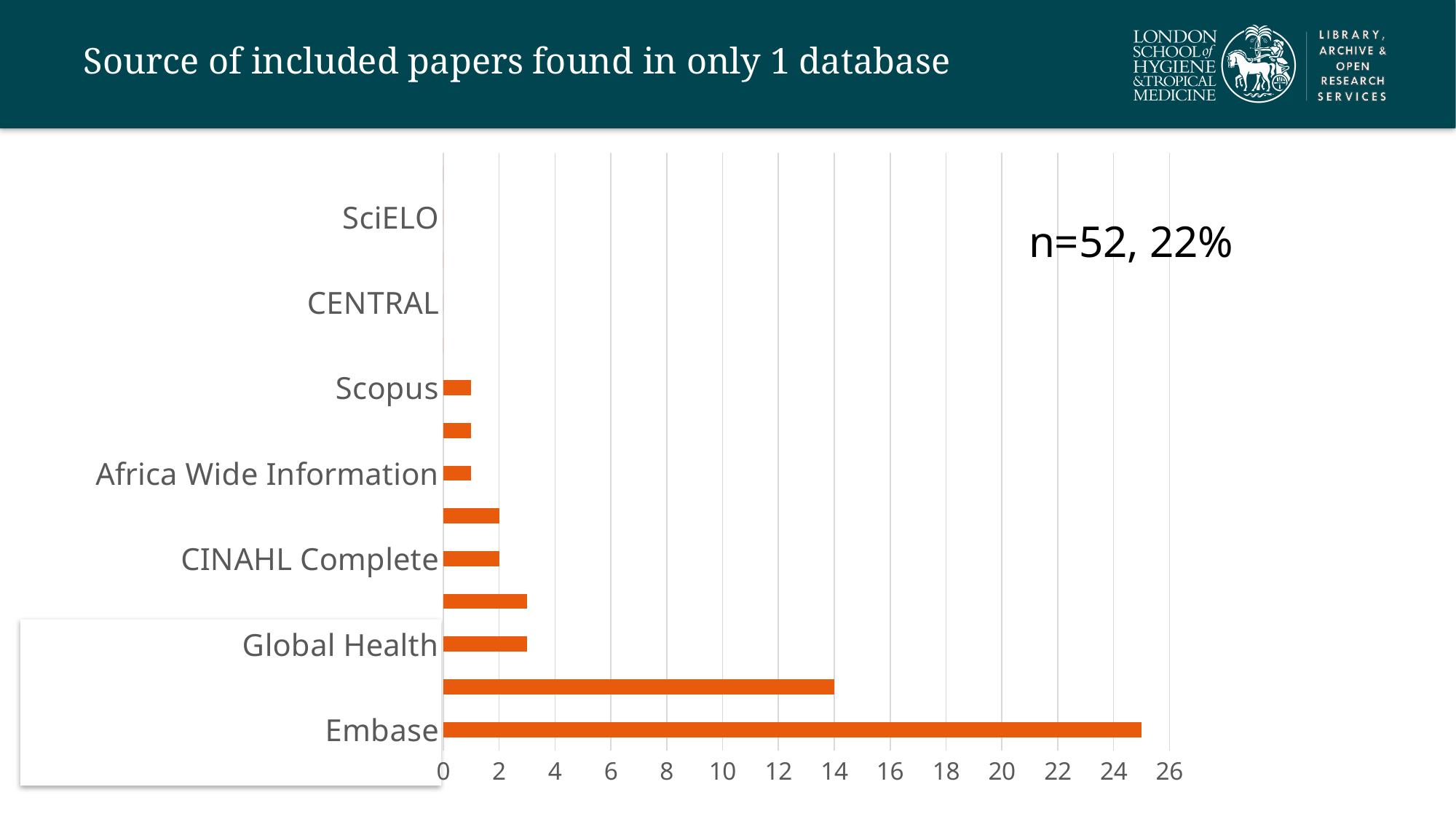
Which has a larger value, Embase or Global Health? Embase What is the value for CINAHL Complete? 2 What is the value for CENTRAL? 0 Which has a larger value, CINAHL Complete or Scopus? CINAHL Complete What is the value for SciELO? 0 What is the title of the chart on the slide? Source of included papers found in only 1 database What kind of chart is shown on the slide? Bar chart Is the value for Scopus greater or less than 2? less Which labeled database has the highest value? Embase Is the value for Embase greater or less than 24? greater Is the value for Global Health greater or less than 4? less What annotation text is printed in the upper right of the chart area? n=52, 22%